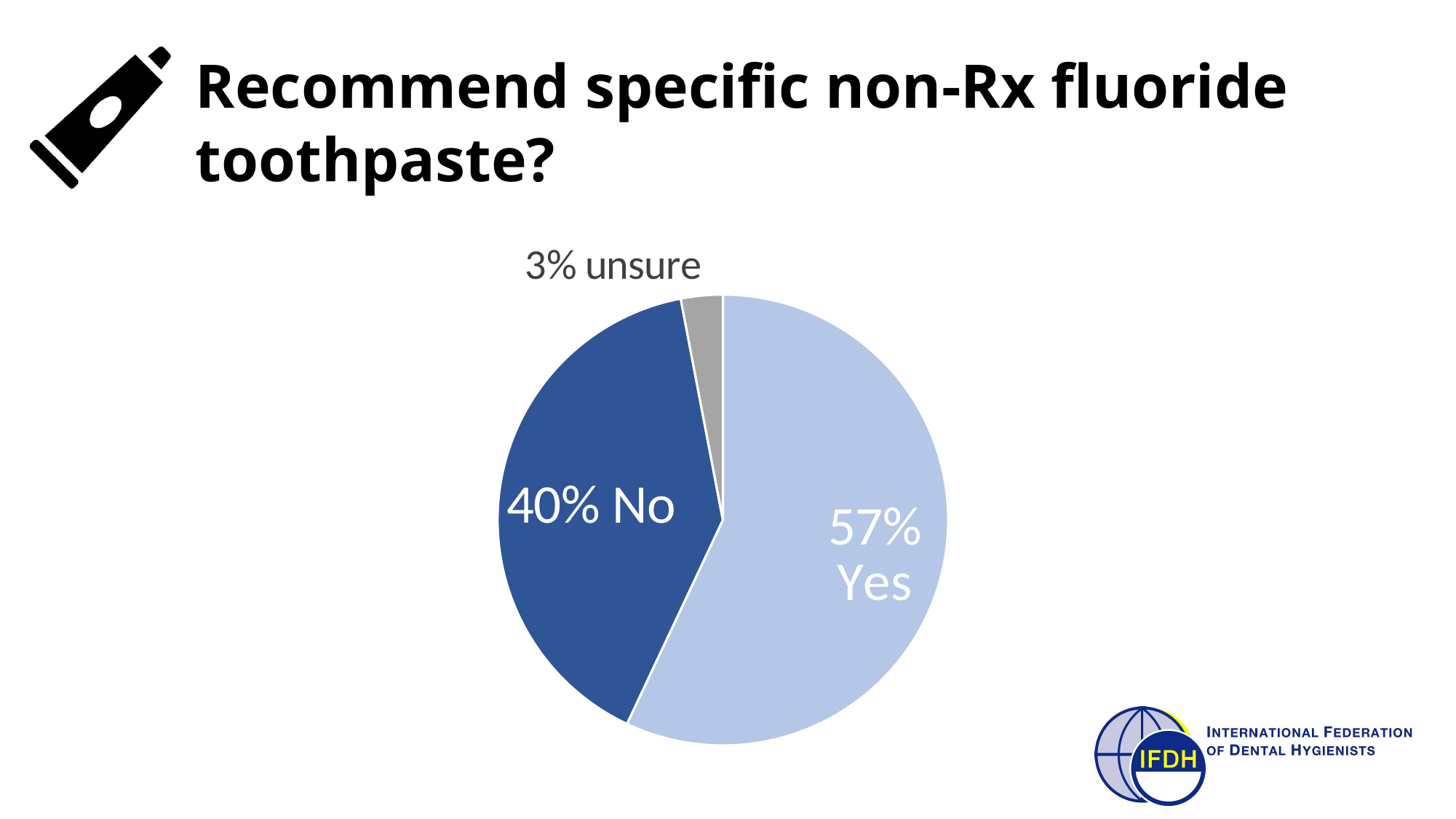
What is the title of the slide containing the pie chart? Recommend specific non-Rx fluoride toothpaste? What is the difference in percentage points between the No and unsure slices? 37 Which response has the largest share of the pie? Yes Which is larger, the Yes slice or the No slice? Yes What kind of chart is shown on the slide? pie chart What colour is the unsure slice of the pie chart? grey How many slices does the pie chart have? 3 What is the difference in percentage points between the Yes and No slices? 17 What percentage of respondents answered No? 40% Which response has the smallest share of the pie? unsure What percentage of respondents were unsure? 3% What percentage of respondents answered Yes? 57%